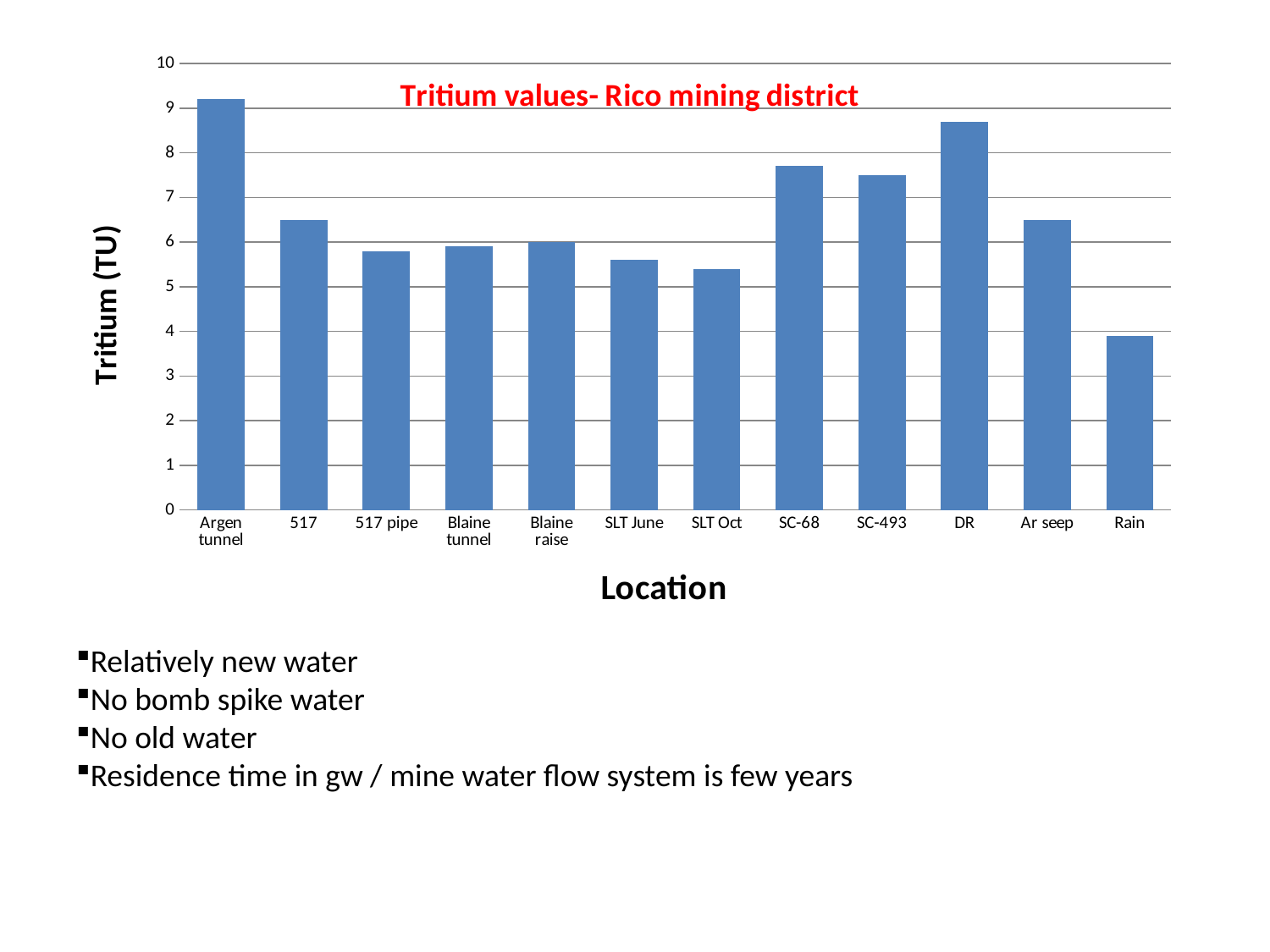
What kind of chart is shown on the slide? bar chart What is the label of the vertical axis? Tritium (TU) What is the title of the chart? Tritium values- Rico mining district How many locations are plotted on the chart? 12 Which has a higher tritium value, Argen tunnel or 517? Argen tunnel Is the tritium value for SC-68 greater or less than 7? greater Is the tritium value for SLT Oct greater or less than 6? less Which location has the highest tritium value? Argen tunnel Is the tritium value for Rain greater or less than 5? less Which has a higher tritium value, SC-68 or SLT Oct? SC-68 Which location has the lowest tritium value? Rain